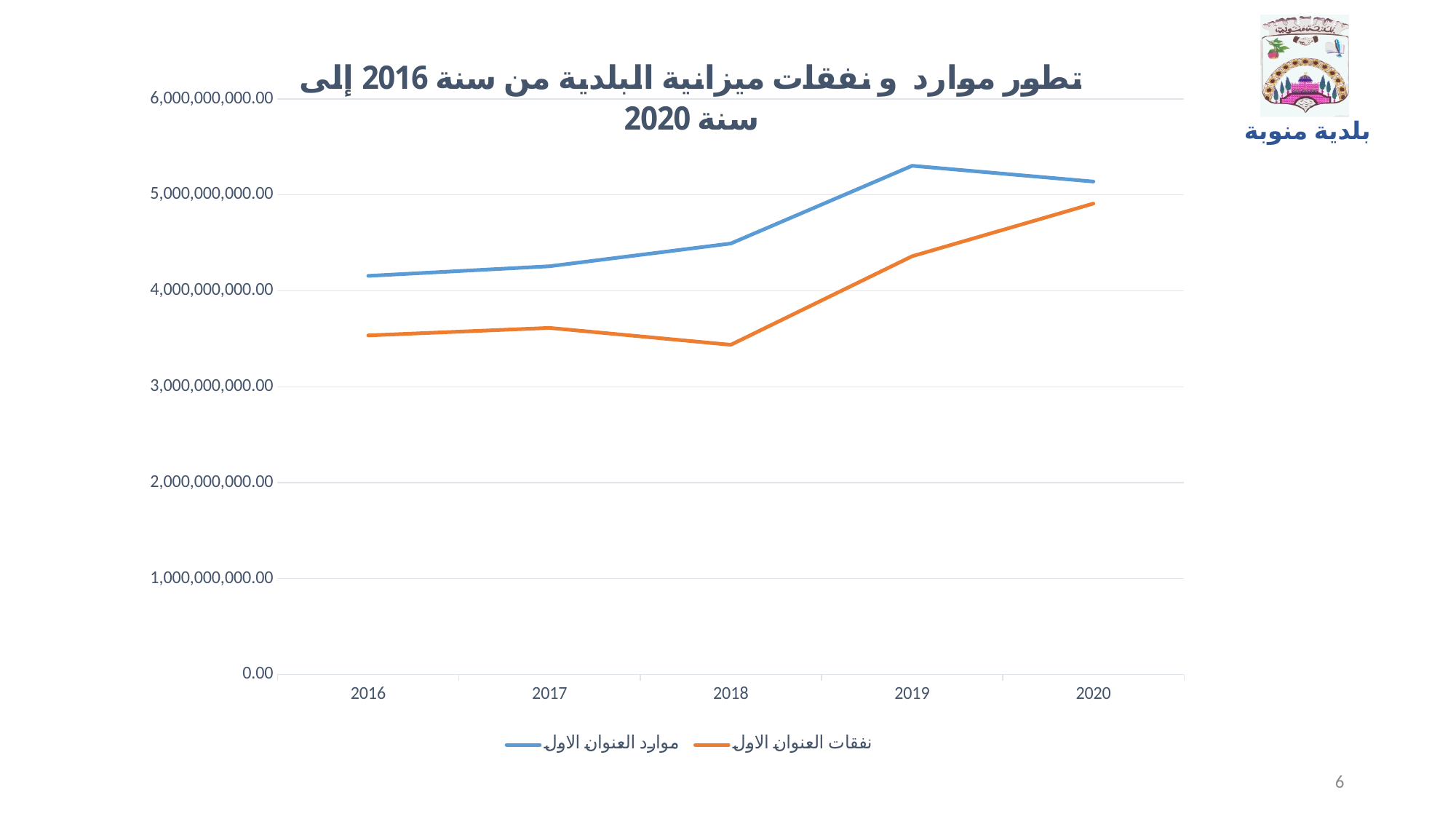
Is the value for موارد العنوان الاول in 2019 greater or less than 5,000,000,000.00? greater Which colour is used for the series نفقات العنوان الاول? orange In which year does the series موارد العنوان الاول reach its highest value? 2019 Is the value for موارد العنوان الاول in 2016 greater or less than 4,000,000,000.00? greater In which year does the series نفقات العنوان الاول reach its highest value? 2020 How many years are plotted along the x axis? 5 In 2019, which series has the larger value, موارد العنوان الاول or نفقات العنوان الاول? موارد العنوان الاول Does the series نفقات العنوان الاول rise or fall from 2018 to 2020? rise In which year is the series موارد العنوان الاول at its lowest value? 2016 What kind of chart is shown on the slide? line chart How many series does the legend list? 2 Is the value for نفقات العنوان الاول in 2018 greater or less than 4,000,000,000.00? less